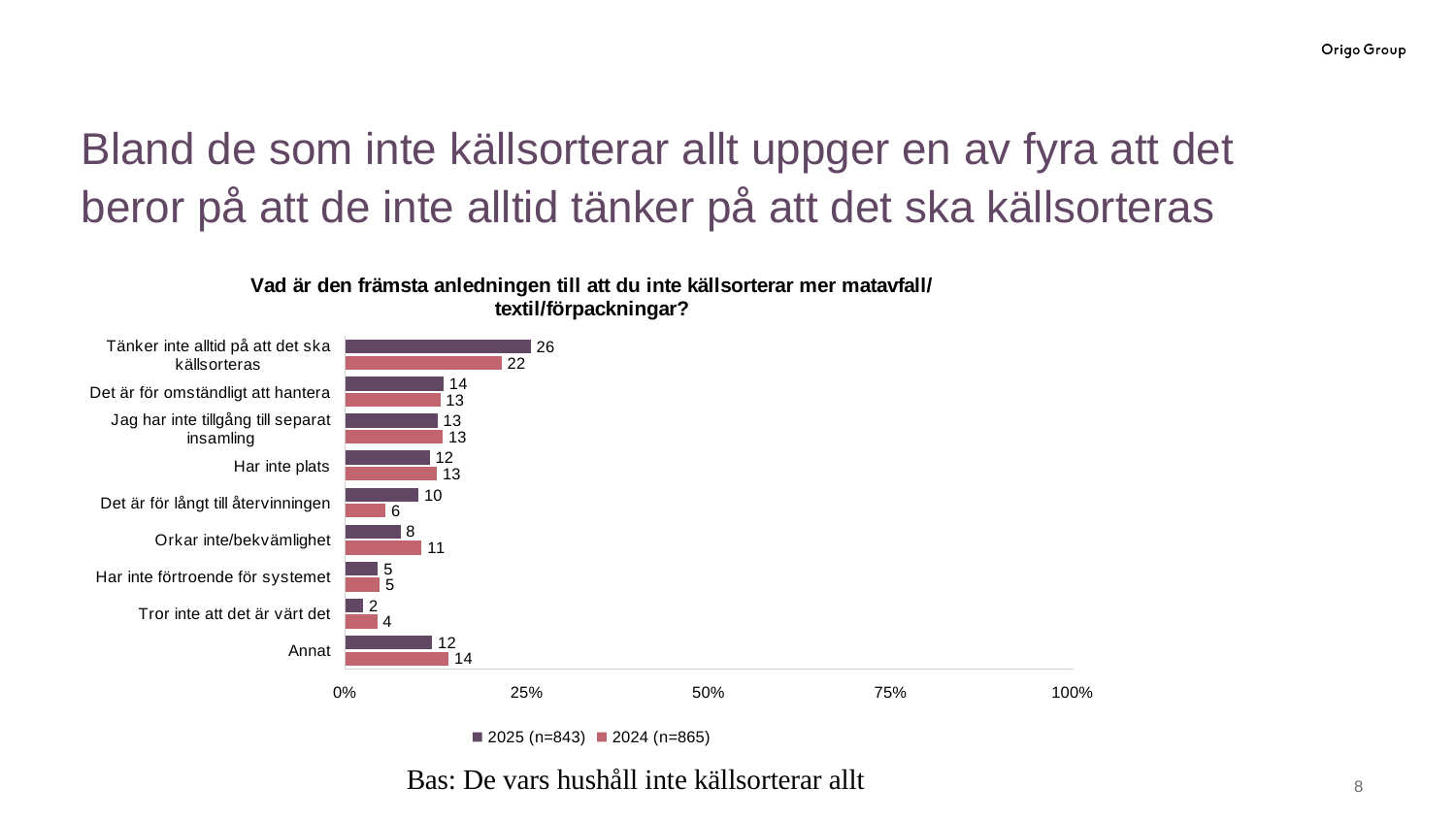
What is the title of the chart? Vad är den främsta anledningen till att du inte källsorterar mer matavfall/ textil/förpackningar? What is the value for 'Tänker inte alltid på att det ska källsorteras' in the 2025 (n=843) series? 26 How many categories are shown on the chart? 9 What is the difference between the 2025 and 2024 values for 'Tänker inte alltid på att det ska källsorteras'? 4 What is the value for 'Orkar inte/bekvämlighet' in the 2024 (n=865) series? 11 For 'Det är för långt till återvinningen', which series has the larger value, 2025 (n=843) or 2024 (n=865)? 2025 (n=843) Which category has the lowest value in the 2025 (n=843) series? Tror inte att det är värt det How many series does the legend list? 2 Is the 2025 value for 'Tänker inte alltid på att det ska källsorteras' greater or less than 50%? less Which category has the highest value in the 2025 (n=843) series? Tänker inte alltid på att det ska källsorteras What kind of chart is shown on the slide? Bar chart What is the value for 'Det är för långt till återvinningen' in the 2024 (n=865) series? 6